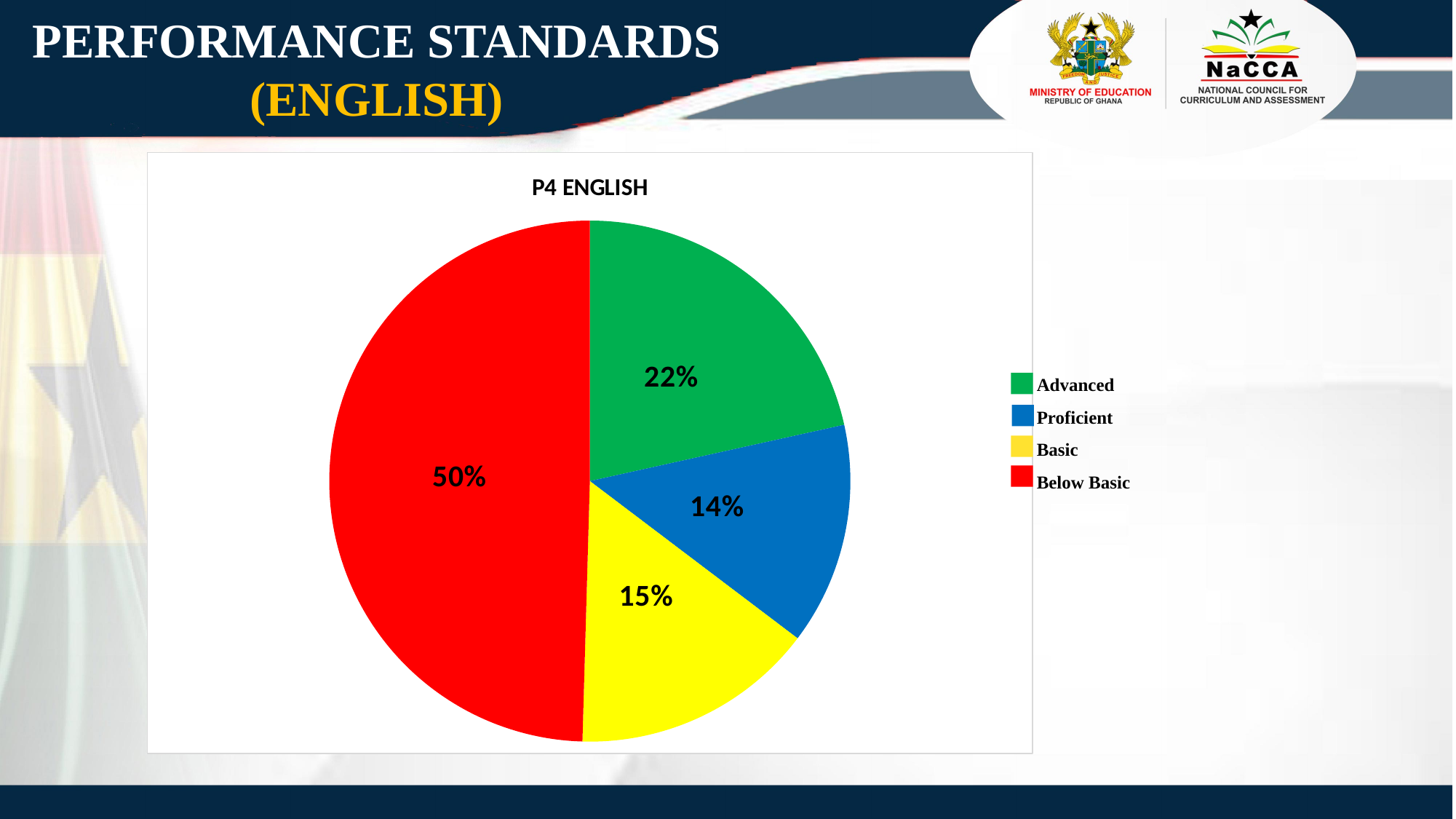
Which category has the smallest share of the pie? Proficient Which is larger, the Advanced share or the Basic share? Advanced What percentage of the pie is Proficient? 14% Which category has the largest share of the pie? Below Basic What colour represents Below Basic in the chart? red What is the title of the chart? P4 ENGLISH What percentage of the pie is Basic? 15% What percentage of the pie is Advanced? 22% What percentage of the pie is Below Basic? 50% How many categories does the legend list? 4 What is the difference in percentage points between Below Basic and Advanced? 28 What type of chart is shown on the slide? pie chart